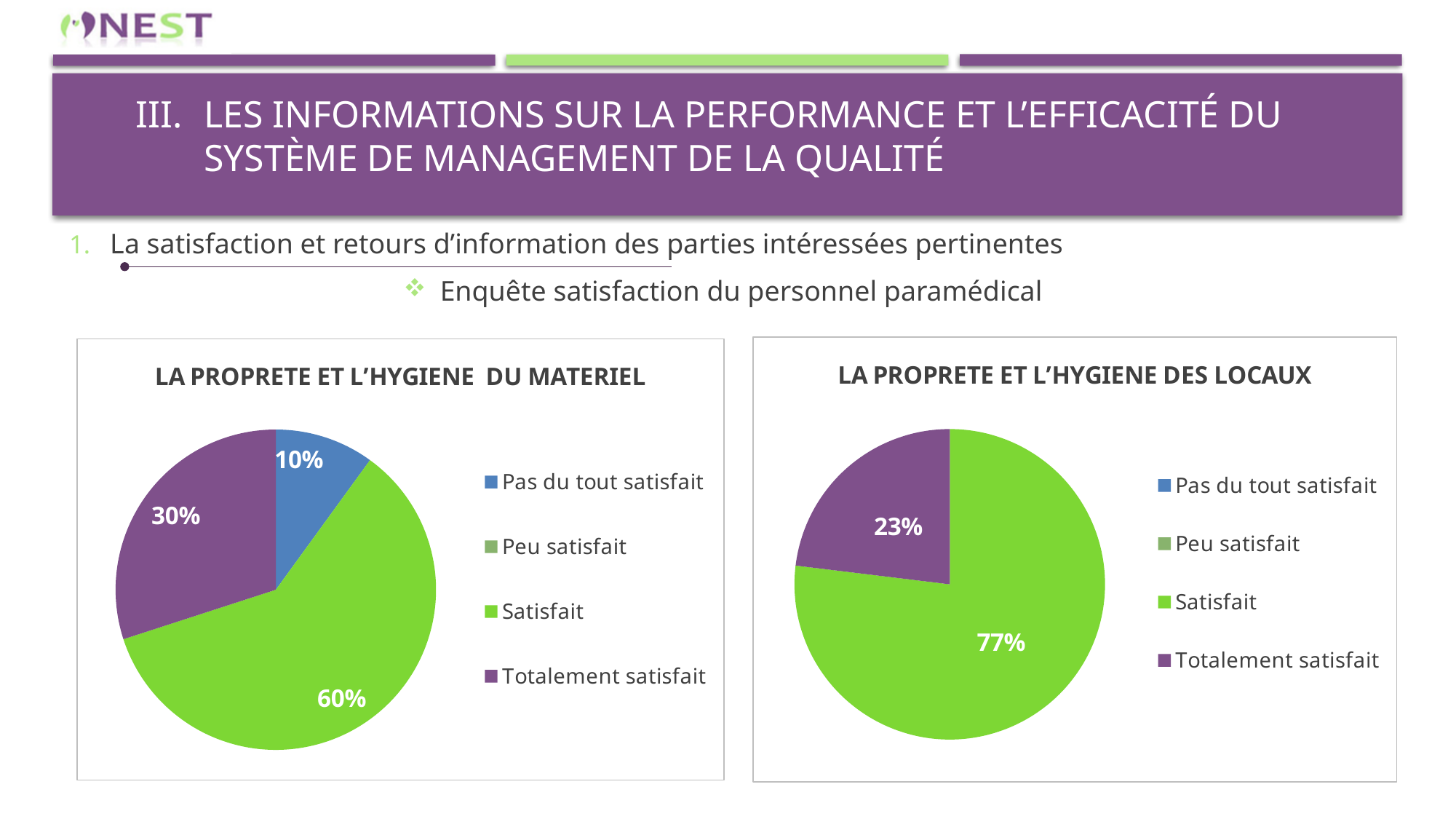
In the 'LA PROPRETE ET L'HYGIENE DU MATERIEL' chart, what is the difference between the 'Satisfait' and 'Totalement satisfait' shares? 30% In the 'LA PROPRETE ET L'HYGIENE DES LOCAUX' chart, what share is 'Totalement satisfait'? 23% In the 'LA PROPRETE ET L'HYGIENE DES LOCAUX' chart, what is the difference between the 'Satisfait' and 'Totalement satisfait' shares? 54% How many entries does the legend of the 'LA PROPRETE ET L'HYGIENE DES LOCAUX' chart list? 4 In the 'LA PROPRETE ET L'HYGIENE DES LOCAUX' chart, what share is 'Satisfait'? 77% In the 'LA PROPRETE ET L'HYGIENE DU MATERIEL' chart, what share is 'Pas du tout satisfait'? 10% In the 'LA PROPRETE ET L'HYGIENE DES LOCAUX' chart, which is larger, 'Satisfait' or 'Totalement satisfait'? Satisfait In the 'LA PROPRETE ET L'HYGIENE DU MATERIEL' chart, which category has the largest slice? Satisfait In the 'LA PROPRETE ET L'HYGIENE DU MATERIEL' chart, which labelled category has the smallest slice? Pas du tout satisfait What kind of chart is used for 'LA PROPRETE ET L'HYGIENE DU MATERIEL'? Pie chart